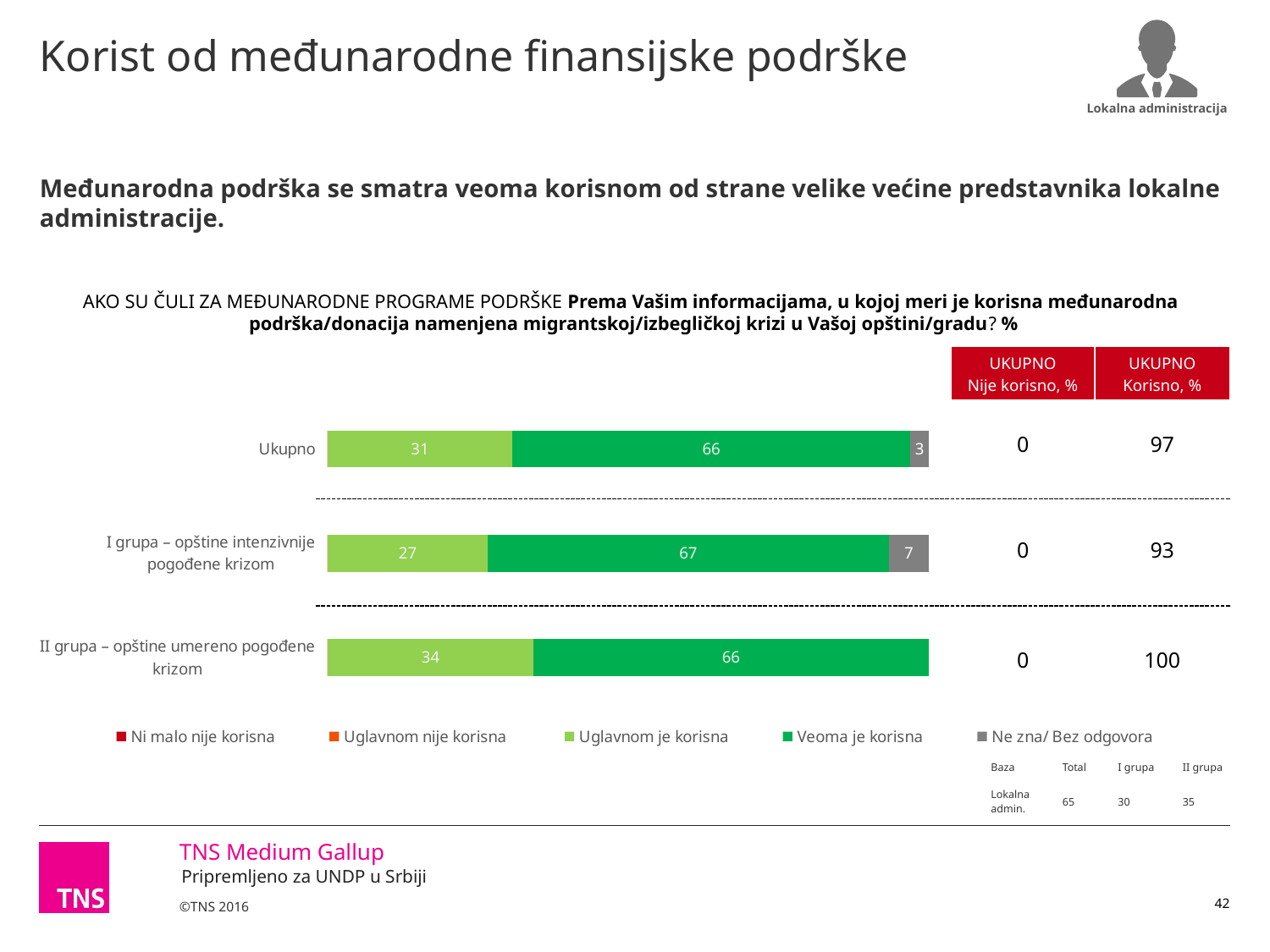
How many series does the chart legend list? 5 How many categories (rows) are plotted in the chart? 3 What is the difference between the "Uglavnom je korisna" values for "II grupa" and "I grupa"? 7 What is the "UKUPNO Korisno, %" value shown for "II grupa – opštine umereno pogođene krizom"? 100 Which category has the highest value for "Uglavnom je korisna"? II grupa – opštine umereno pogođene krizom Which is larger: the "Ne zna/ Bez odgovora" value for "Ukupno" or for "I grupa"? I grupa What is the value of "Veoma je korisna" for the "Ukupno" category? 66 What is the value of "Ne zna/ Bez odgovora" for "I grupa – opštine intenzivnije pogođene krizom"? 7 What is the value of "Uglavnom je korisna" for "I grupa – opštine intenzivnije pogođene krizom"? 27 What kind of chart is shown on the slide? stacked bar chart What is the "UKUPNO Korisno, %" value shown for "Ukupno"? 97 Which category has the lowest value for "Uglavnom je korisna"? I grupa – opštine intenzivnije pogođene krizom